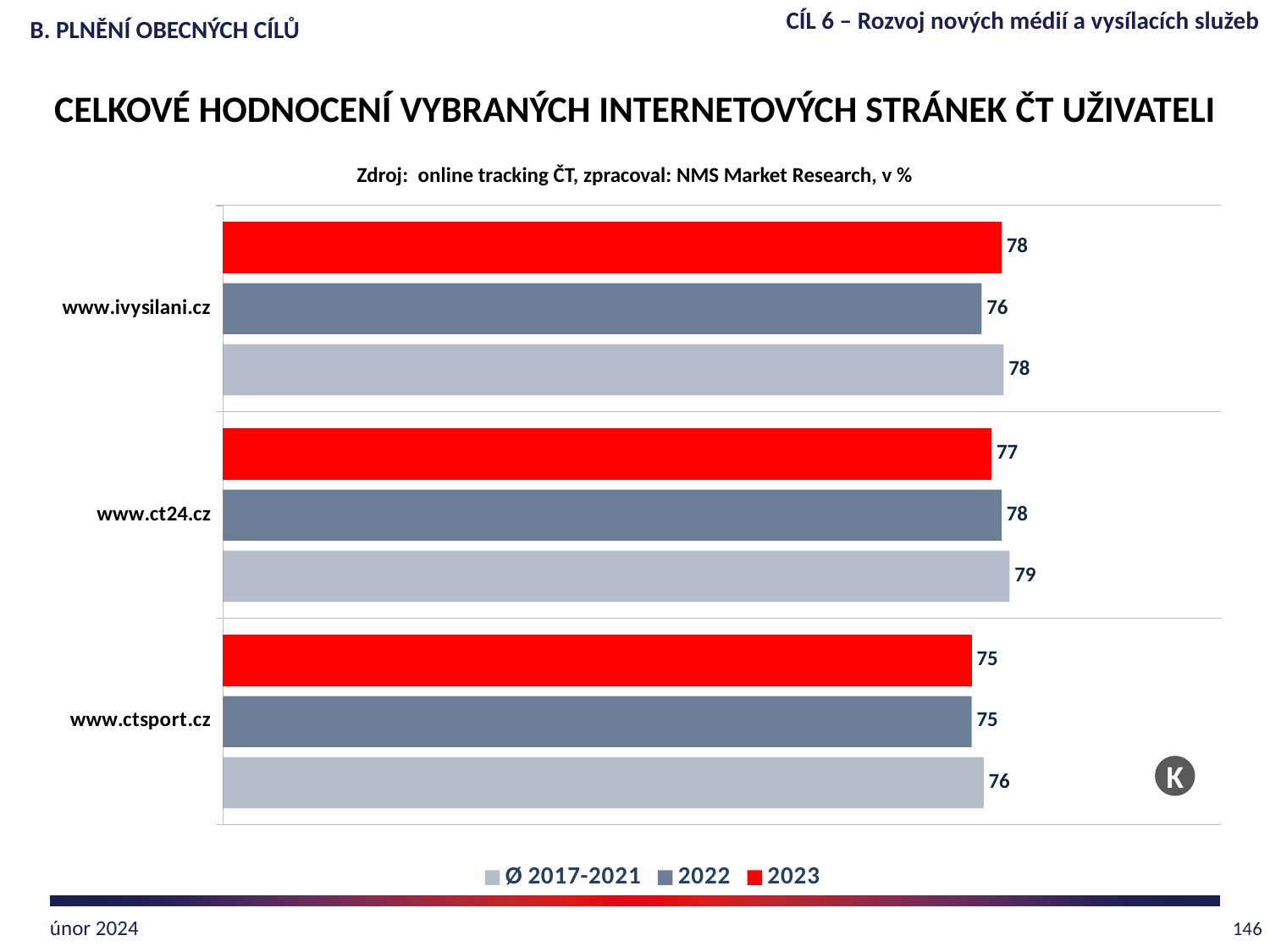
For www.ct24.cz, which is larger: the Ø 2017-2021 value or the 2023 value? Ø 2017-2021 What is the difference between the 2023 value and the 2022 value for www.ivysilani.cz? 2 What is the 2022 value for www.ct24.cz? 78 How many series does the legend list? 3 How many websites are shown in the chart? 3 What is the Ø 2017-2021 value for www.ctsport.cz? 76 What is the 2023 value for www.ctsport.cz? 75 What kind of chart is shown on the slide? bar chart What is the 2023 value for www.ivysilani.cz? 78 Which website has the highest Ø 2017-2021 value? www.ct24.cz Which colour represents the 2023 series in the chart? red Which website has the lowest 2023 value? www.ctsport.cz